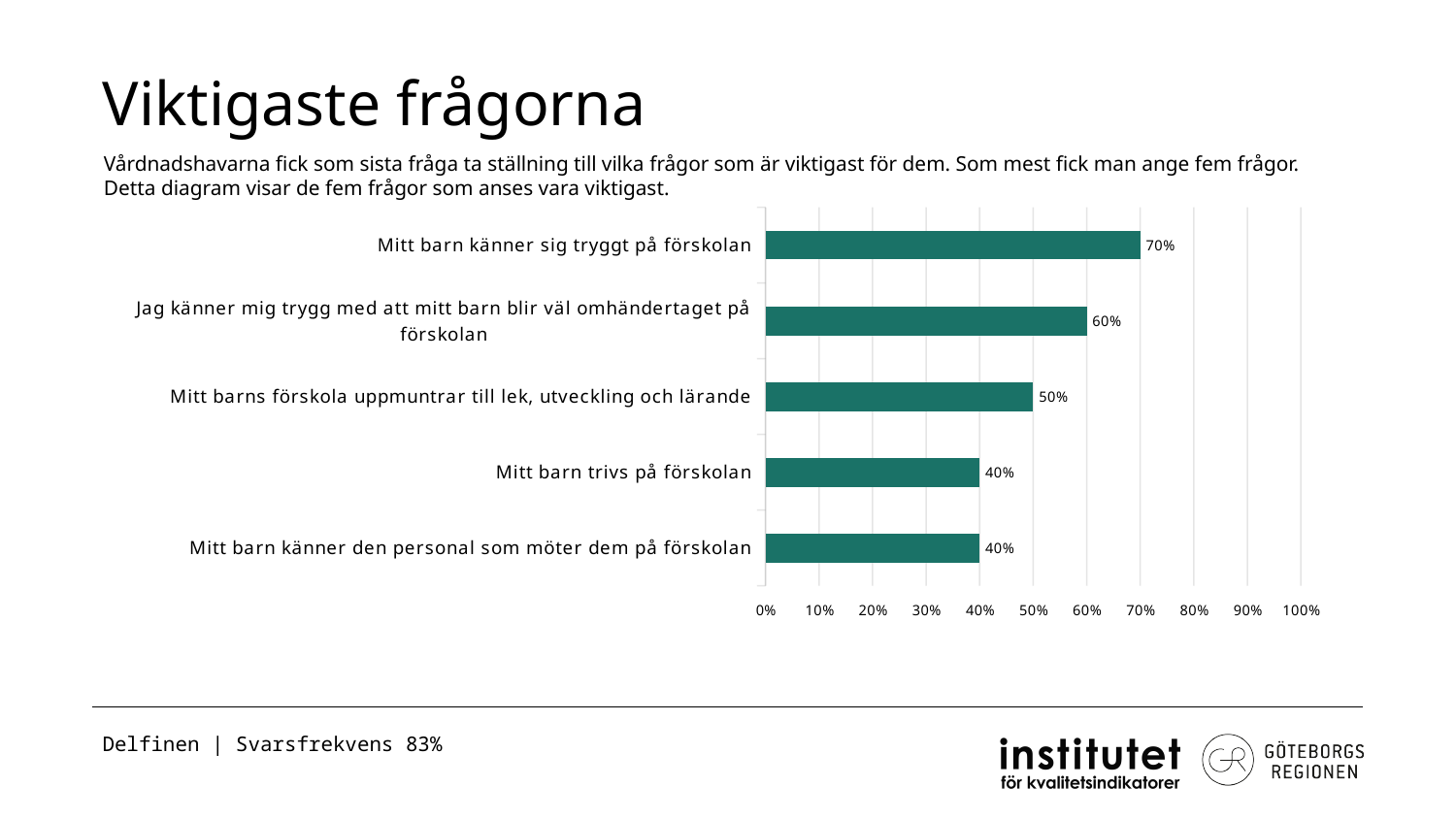
What is the value for "Jag känner mig trygg med att mitt barn blir väl omhändertaget på förskolan"? 60% Is the value for "Mitt barn känner den personal som möter dem på förskolan" greater or less than 50%? less What is the title of the slide? Viktigaste frågorna Which category has the highest value? Mitt barn känner sig tryggt på förskolan What is the value for "Mitt barn känner sig tryggt på förskolan"? 70% Which is larger: "Jag känner mig trygg med att mitt barn blir väl omhändertaget på förskolan" or "Mitt barns förskola uppmuntrar till lek, utveckling och lärande"? Jag känner mig trygg med att mitt barn blir väl omhändertaget på förskolan What is the value for "Mitt barns förskola uppmuntrar till lek, utveckling och lärande"? 50% What is the difference between "Mitt barn känner sig tryggt på förskolan" and "Mitt barn trivs på förskolan"? 30% What is the difference between "Jag känner mig trygg med att mitt barn blir väl omhändertaget på förskolan" and "Mitt barns förskola uppmuntrar till lek, utveckling och lärande"? 10% What is the maximum value shown on the x axis? 100% How many categories are shown in the chart? 5 What kind of chart is shown on the slide? bar chart